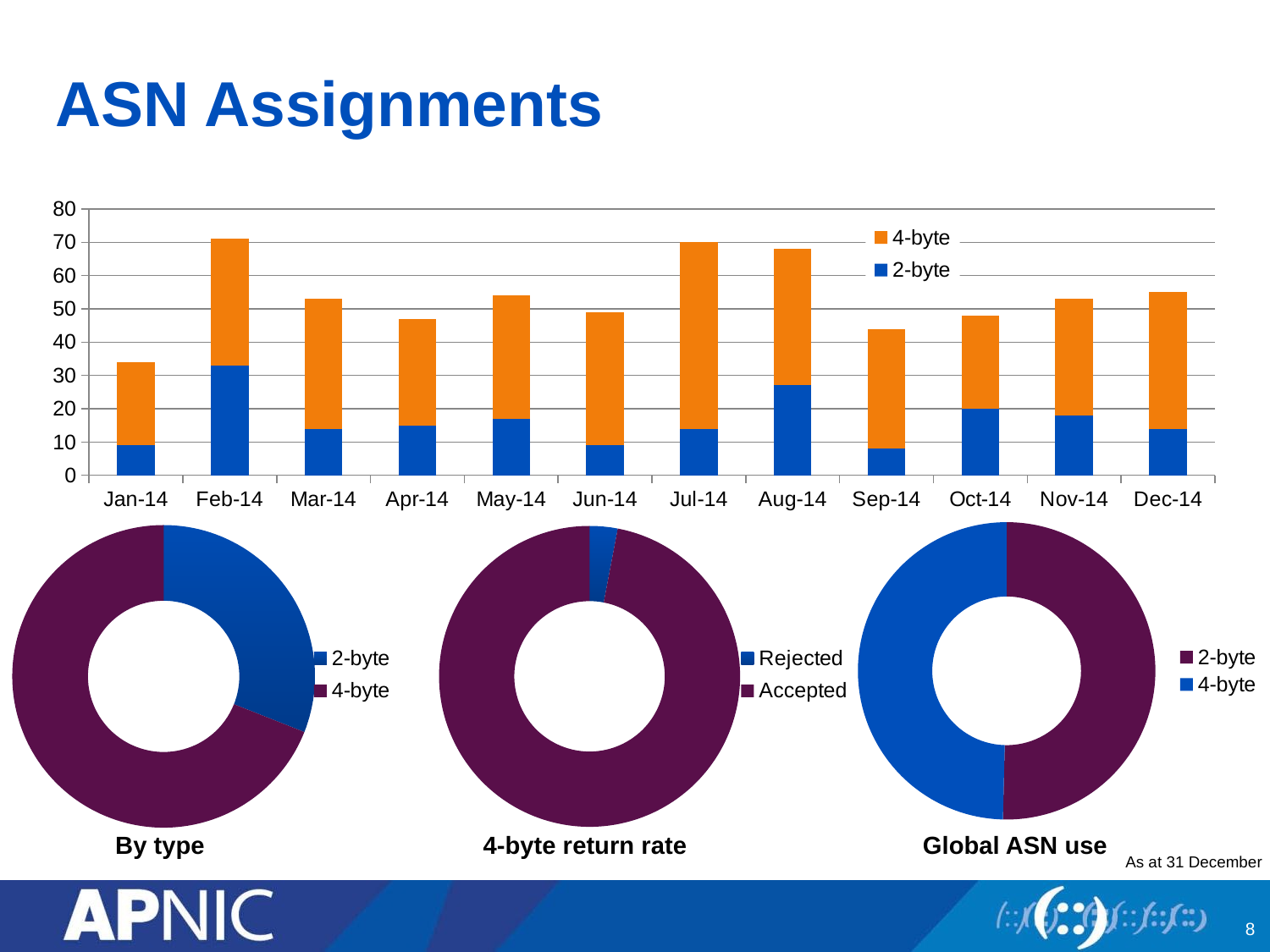
What kind of chart is the top chart on the slide? Stacked bar chart In the '4-byte return rate' donut chart, which is larger, Rejected or Accepted? Accepted In the top bar chart, is the 2-byte value for Aug-14 greater or less than 20? greater In the 'By type' donut chart, which is larger, 2-byte or 4-byte? 4-byte In the top bar chart, which month has the lowest total bar? Jan-14 In the top bar chart, is the total for Jul-14 greater or less than 60? greater In the top bar chart, how many series does the legend list? 2 In the top bar chart, which month has the largest 4-byte segment? Jul-14 In the top bar chart, is the total for Jan-14 greater or less than 40? less In the top bar chart, which month has the highest total bar? Feb-14 In the top bar chart, how many months are shown on the x axis? 12 In the top bar chart, which month has the largest 2-byte segment? Feb-14